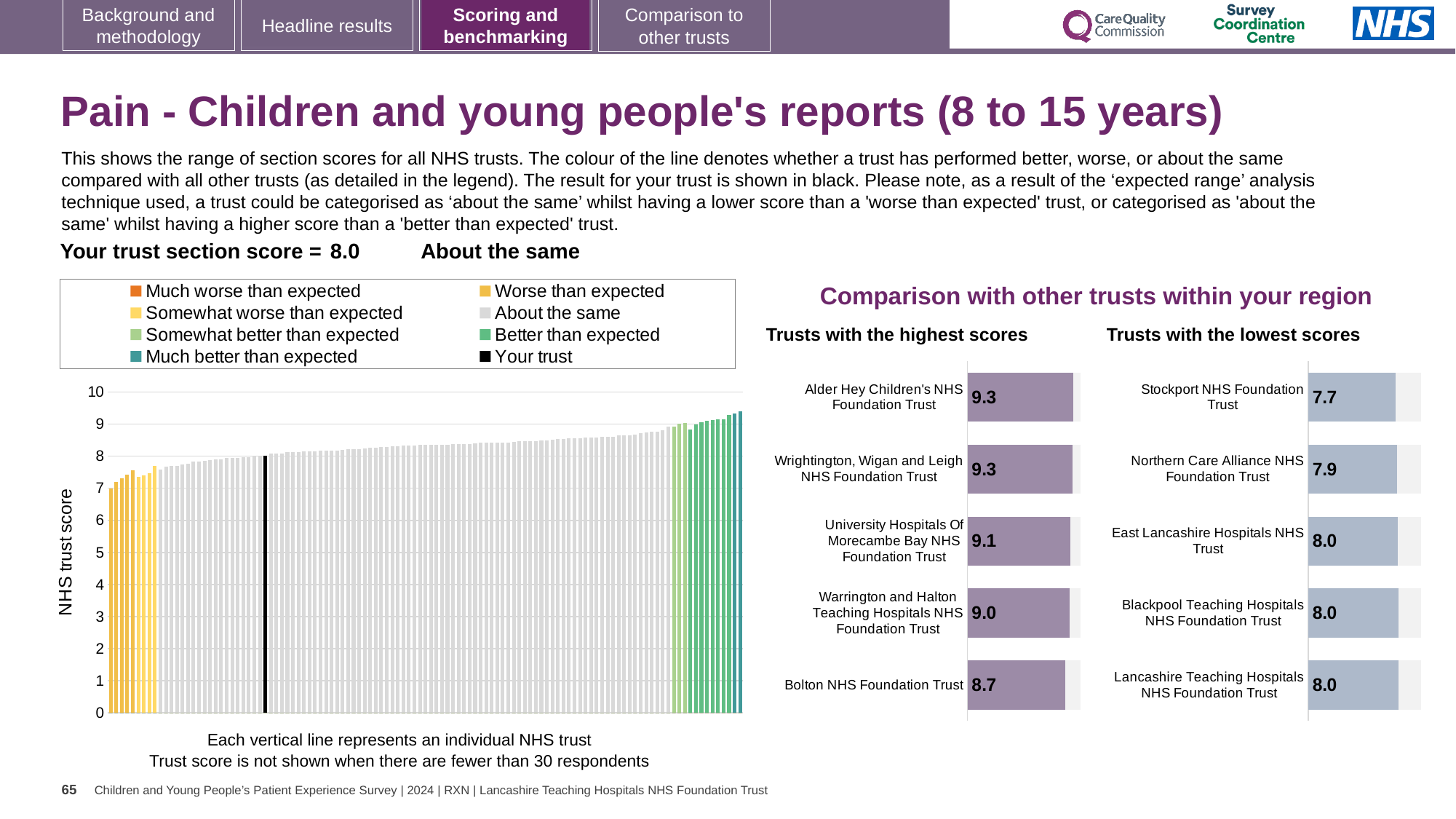
In the 'Trusts with the highest scores' chart, what is the score for Alder Hey Children's NHS Foundation Trust? 9.3 How many trusts are shown in the 'Trusts with the lowest scores' chart? 5 In the 'Trusts with the highest scores' chart, what is the difference between the score for Alder Hey Children's NHS Foundation Trust and the score for Bolton NHS Foundation Trust? 0.6 In the 'Trusts with the lowest scores' chart, what is the score for Stockport NHS Foundation Trust? 7.7 In the 'Trusts with the lowest scores' chart, what is the difference between the score for Northern Care Alliance NHS Foundation Trust and the score for Stockport NHS Foundation Trust? 0.2 In the main chart on the left, is the value for the leftmost (lowest) trust greater or less than 8? less How many entries does the legend of the main chart on the left list? 8 What kind of chart is the main chart on the left of the slide? bar chart In the 'Trusts with the highest scores' chart, which is larger: the score for University Hospitals Of Morecambe Bay NHS Foundation Trust or the score for Warrington and Halton Teaching Hospitals NHS Foundation Trust? University Hospitals Of Morecambe Bay NHS Foundation Trust In the 'Trusts with the highest scores' chart, what is the score for Bolton NHS Foundation Trust? 8.7 In the main chart on the left, do the trust scores rise or fall from left to right along the x axis? rise In the 'Trusts with the lowest scores' chart, which trust has the lowest score? Stockport NHS Foundation Trust